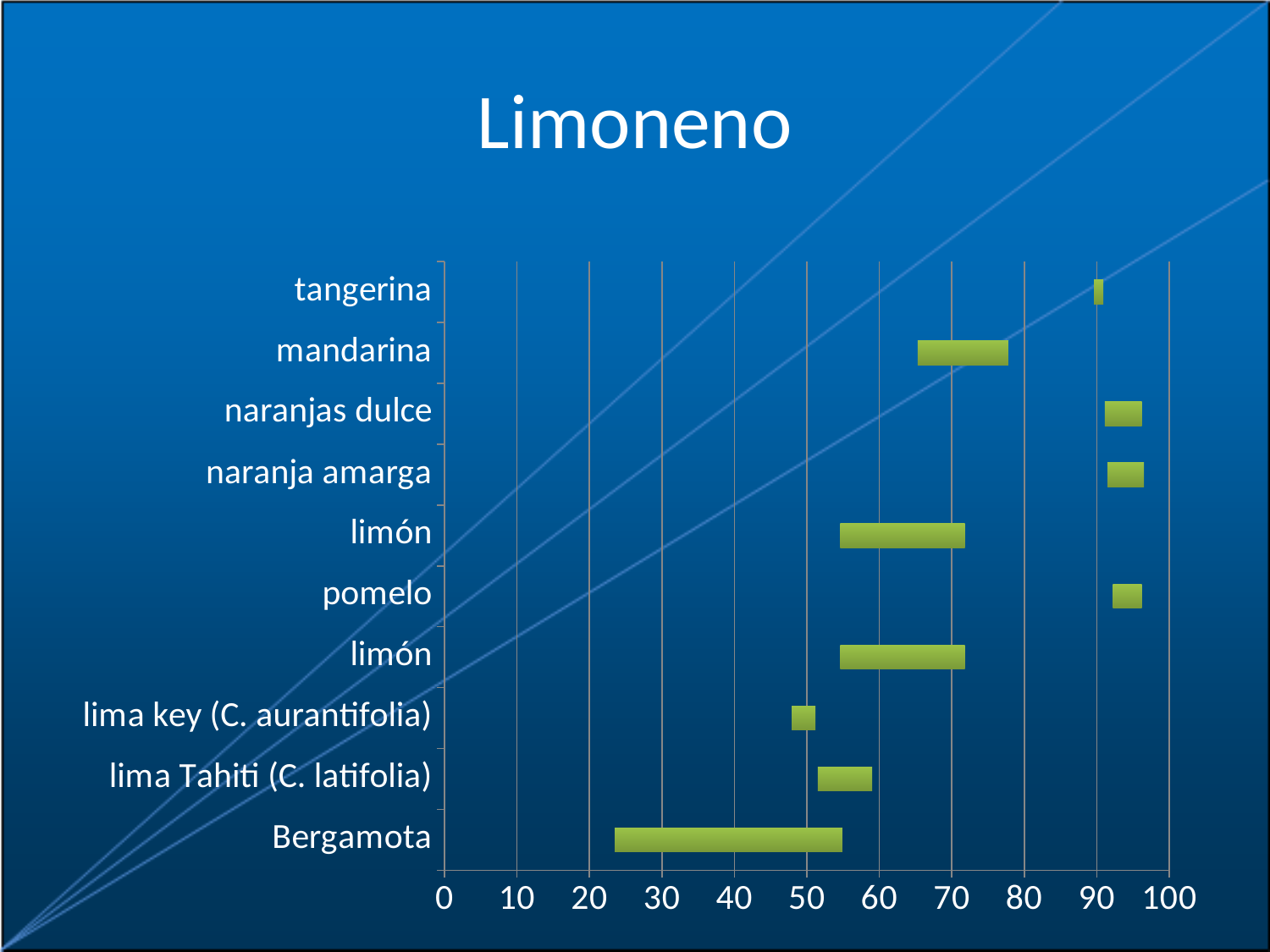
Which category's bar starts at the lowest value on the horizontal axis? Bergamota Which category has the widest bar in the chart? Bergamota Does the bar for Bergamota start at a value greater or less than 30? less Does the bar for mandarina extend to a value greater or less than 70? greater How many categories are listed on the vertical axis of the chart? 10 What is the title of the chart? Limoneno Which category has the narrowest bar in the chart? tangerina What kind of chart is shown on the slide? bar chart Which bar is wider, the one for mandarina or the one for tangerina? mandarina What is the highest value shown on the horizontal axis of the chart? 100 Is the bar for lima Tahiti (C. latifolia) positioned at values greater or less than 70? less